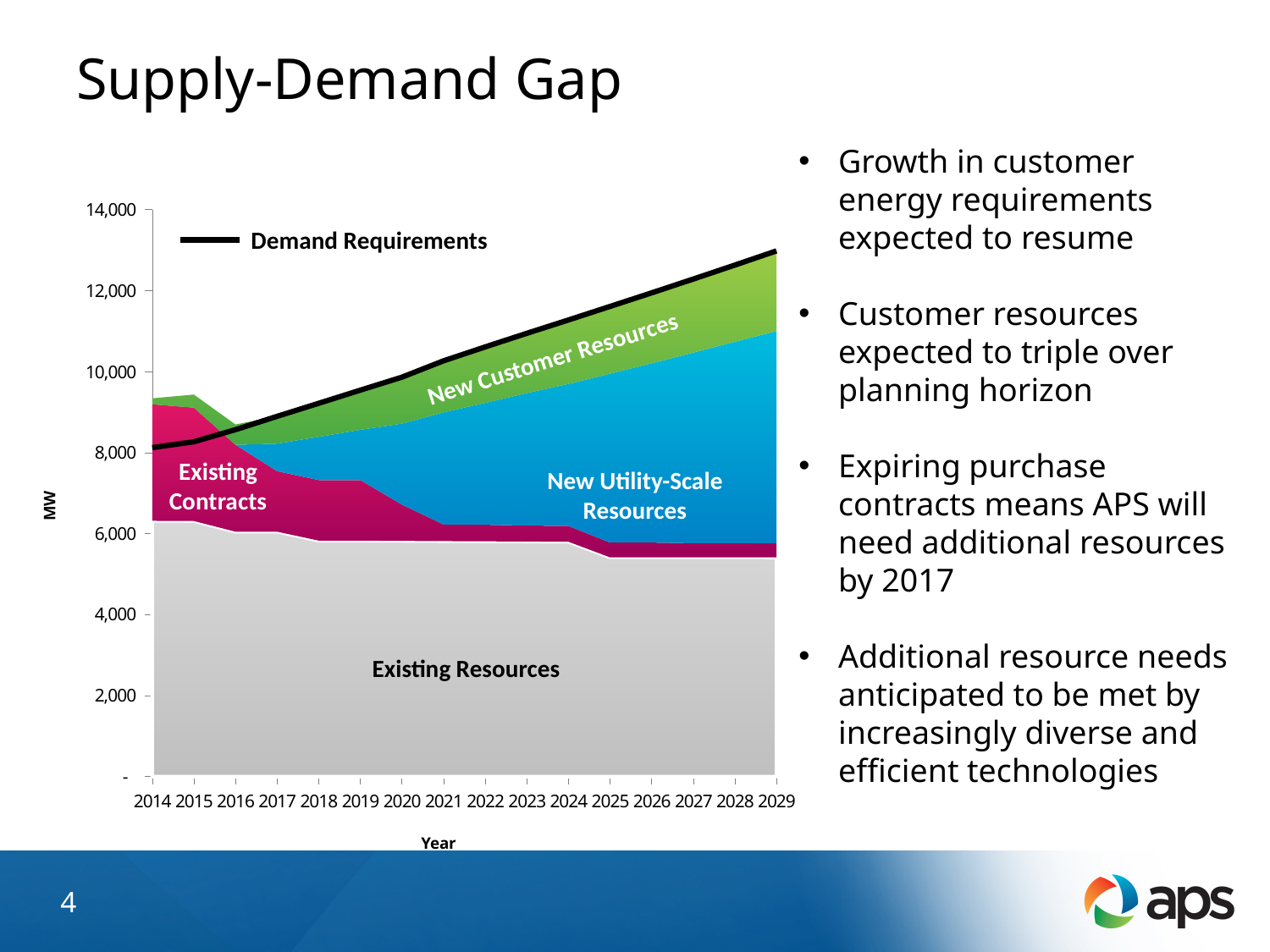
Is the Demand Requirements value larger in 2014 or in 2029? 2029 What is the last year shown on the x axis? 2029 Does the Demand Requirements line rise or fall from 2014 to 2029? Rises How many years are shown along the x axis of the chart? 16 What is the label on the y axis of the chart? MW Does the Existing Resources area rise or fall from 2014 to 2029? Falls Is the Existing Resources value in 2029 greater or less than 6,000? less What kind of chart is shown on the slide? Area and line chart What is the highest value shown on the y axis? 14,000 Is the Demand Requirements value in 2029 greater or less than 12,000? greater Is the Demand Requirements value in 2014 greater or less than 10,000? less